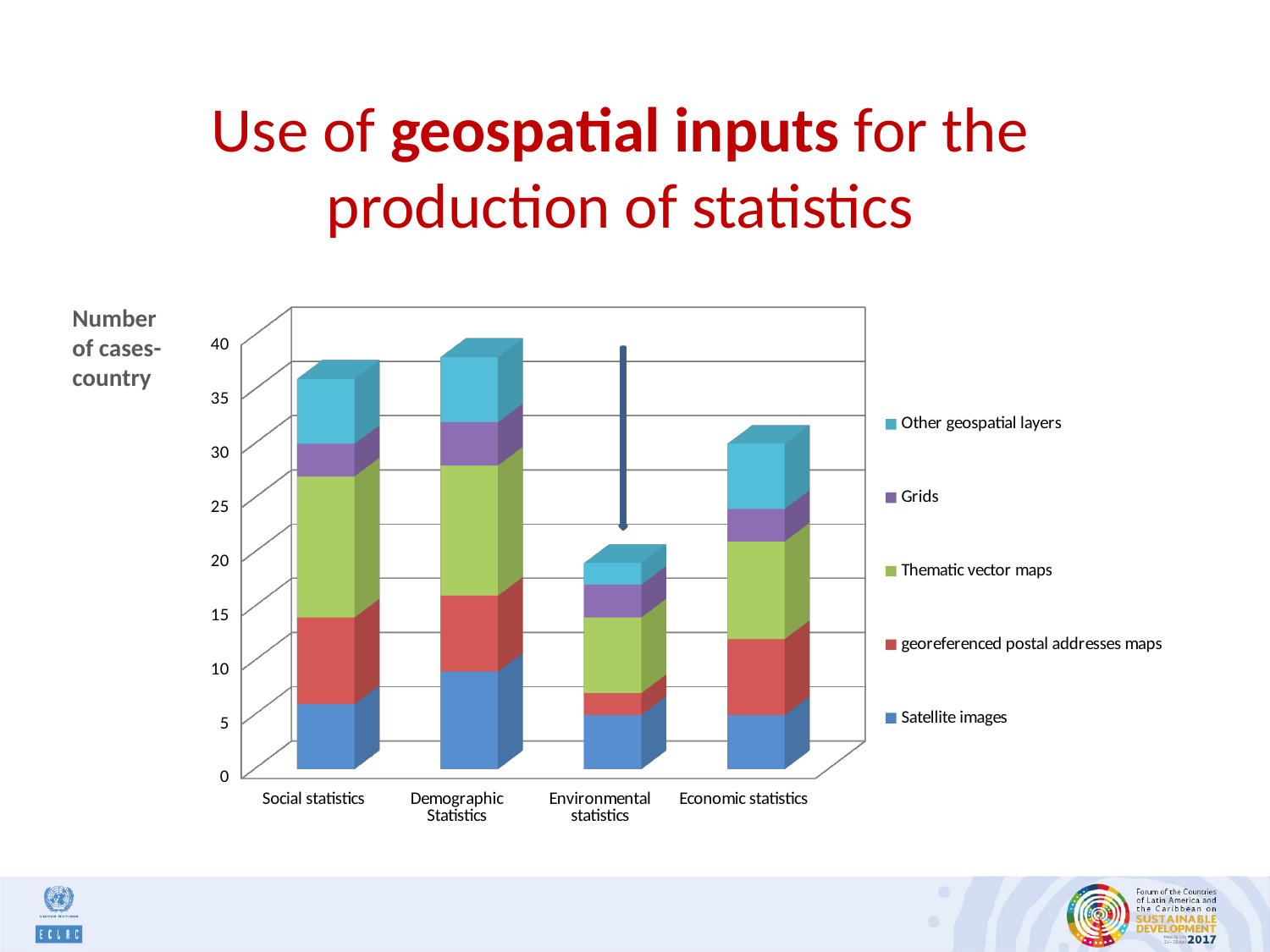
How many categories are shown on the x axis of the chart? 4 Is the total for Social statistics greater or less than 30? greater Which category has the lowest total stacked bar? Environmental statistics Which has the larger total stacked bar, Social statistics or Economic statistics? Social statistics What label is shown on the vertical axis of the chart? Number of cases-country How many series does the chart's legend list? 5 Which has the larger total stacked bar, Environmental statistics or Economic statistics? Economic statistics Which series is shown at the bottom of each stacked bar, according to the legend? Satellite images Which category has the highest total stacked bar? Demographic Statistics Is the total for Economic statistics greater or less than 25? greater Is the total for Environmental statistics greater or less than 25? less What kind of chart is shown on the slide? Stacked bar chart